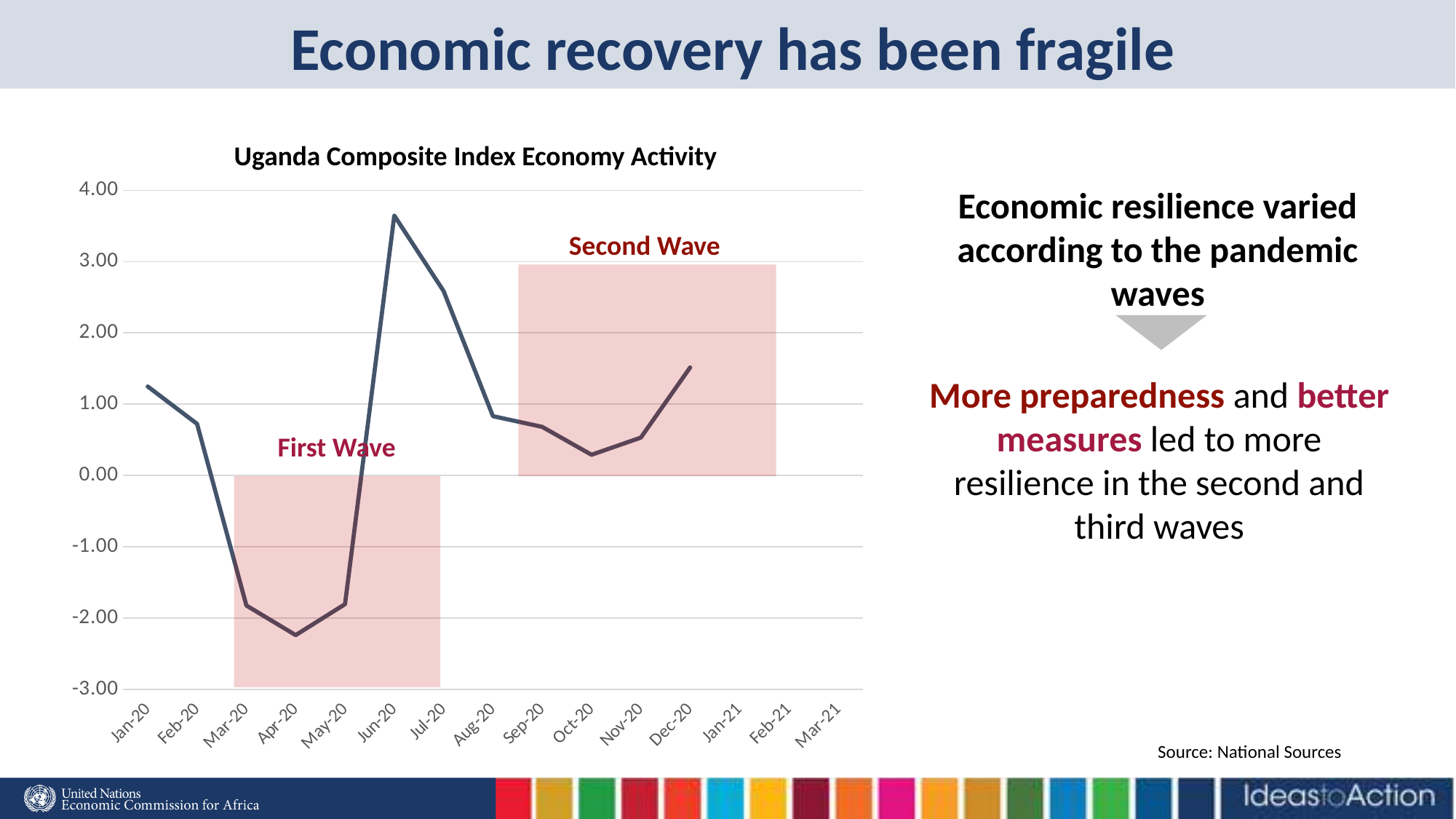
Does the index rise or fall from Jan-20 to Apr-20? Fall How many month labels are shown on the x axis? 15 Is the value for Jun-20 greater or less than 3.00? greater In which month does the Uganda Composite Index Economy Activity reach its highest value? Jun-20 Is the value for Oct-20 greater or less than 1.00? less Is the value for Apr-20 greater or less than -2.00? less What is the title of the chart? Uganda Composite Index Economy Activity What kind of chart is shown on the slide? Line chart What are the two shaded regions on the chart labelled? First Wave and Second Wave In which month does the Uganda Composite Index Economy Activity reach its lowest value? Apr-20 Which month has the larger value, Jul-20 or Aug-20? Jul-20